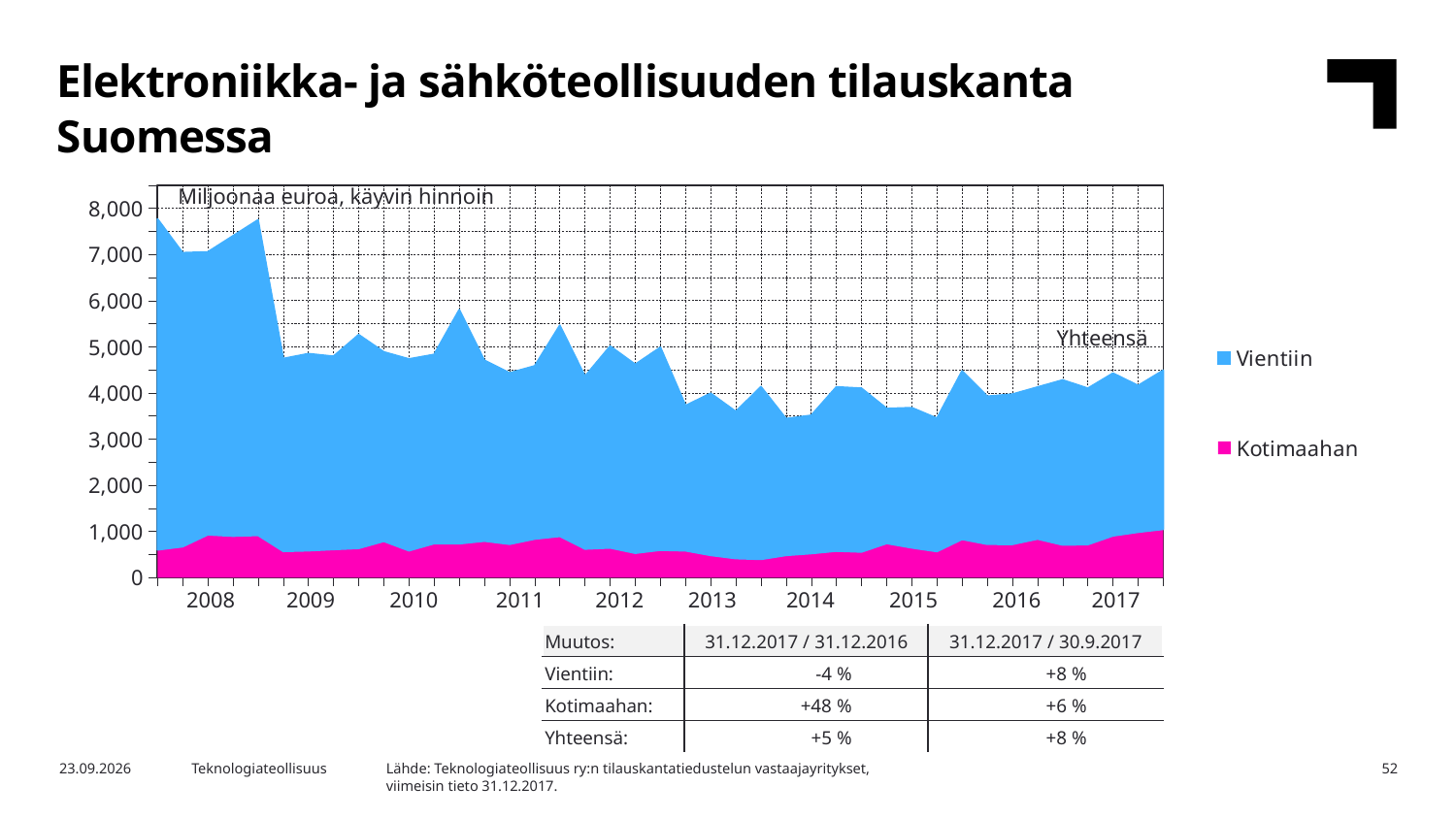
In which year does the total order book reach its highest level? 2008 Is the total order book (Yhteensä) at the start of 2008 greater or less than 7,000? greater Which series, Vientiin or Kotimaahan, has the larger values throughout the chart? Vientiin How many series does the legend list? 2 Is the Kotimaahan value in 2013 greater or less than 1,000? less What unit is stated at the top of the chart area? Miljoonaa euroa, käyvin hinnoin Is the total order book (Yhteensä) at the end of 2017 greater or less than 5,000? less How many years are labelled on the x axis? 10 What kind of chart is shown on the slide? Stacked area chart What are the two series named in the legend? Vientiin and Kotimaahan Does the total order book overall rise or fall from 2008 to 2017? fall